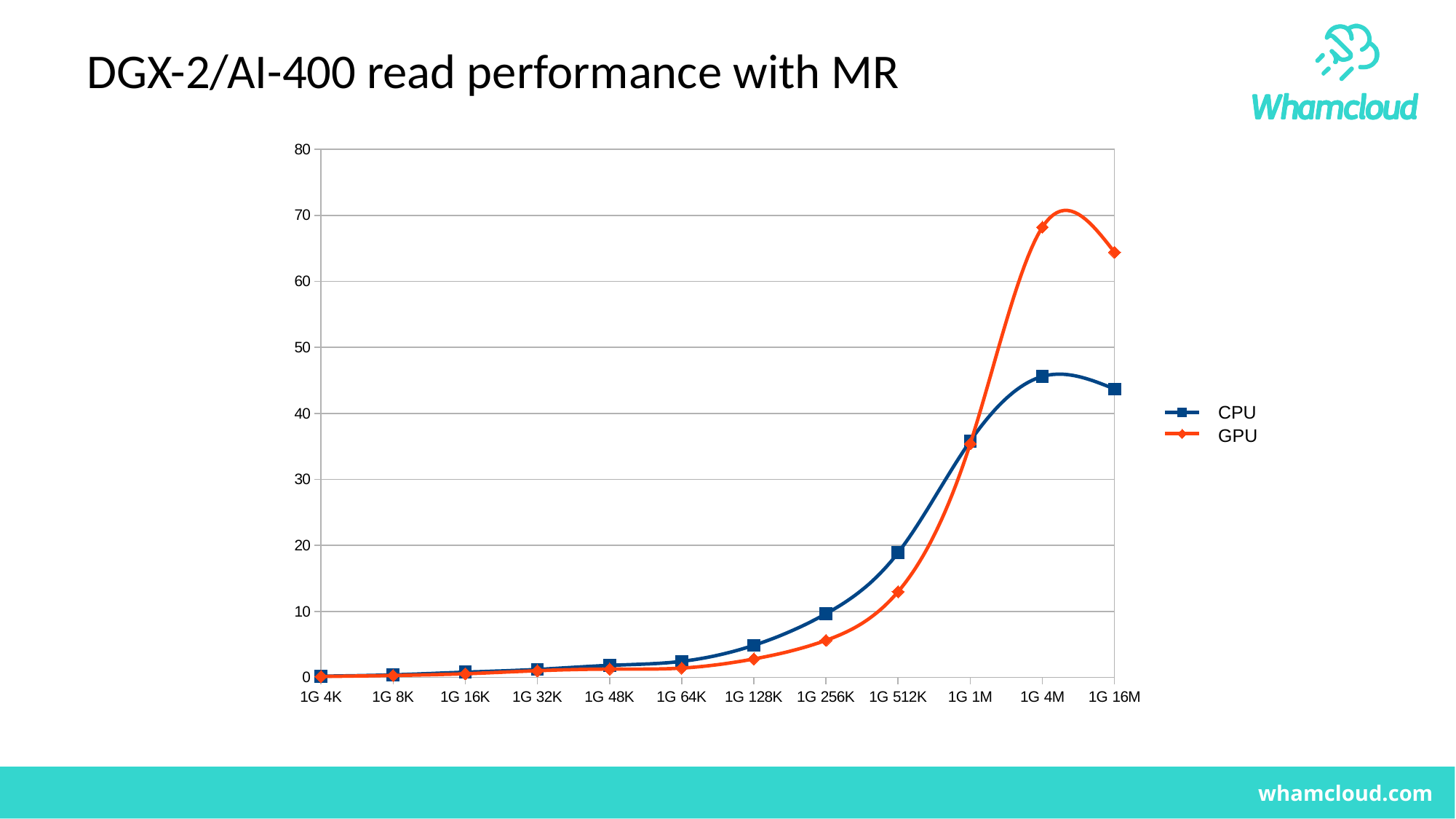
At which category does the CPU series reach its highest value? 1G 4M What is the title of the chart? DGX-2/AI-400 read performance with MR At 1G 512K, which series has the larger value, CPU or GPU? CPU How many categories are shown on the x axis? 12 Does the GPU series rise or fall from 1G 4M to 1G 16M? fall At which category does the GPU series reach its highest value? 1G 4M Is the GPU value at 1G 4M greater or less than 60? greater At 1G 4M, which series has the larger value, CPU or GPU? GPU How many series does the legend list? 2 Is the CPU value at 1G 4M greater or less than 50? less Is the CPU value at 1G 16M greater or less than 40? greater What kind of chart is shown on the slide? line chart